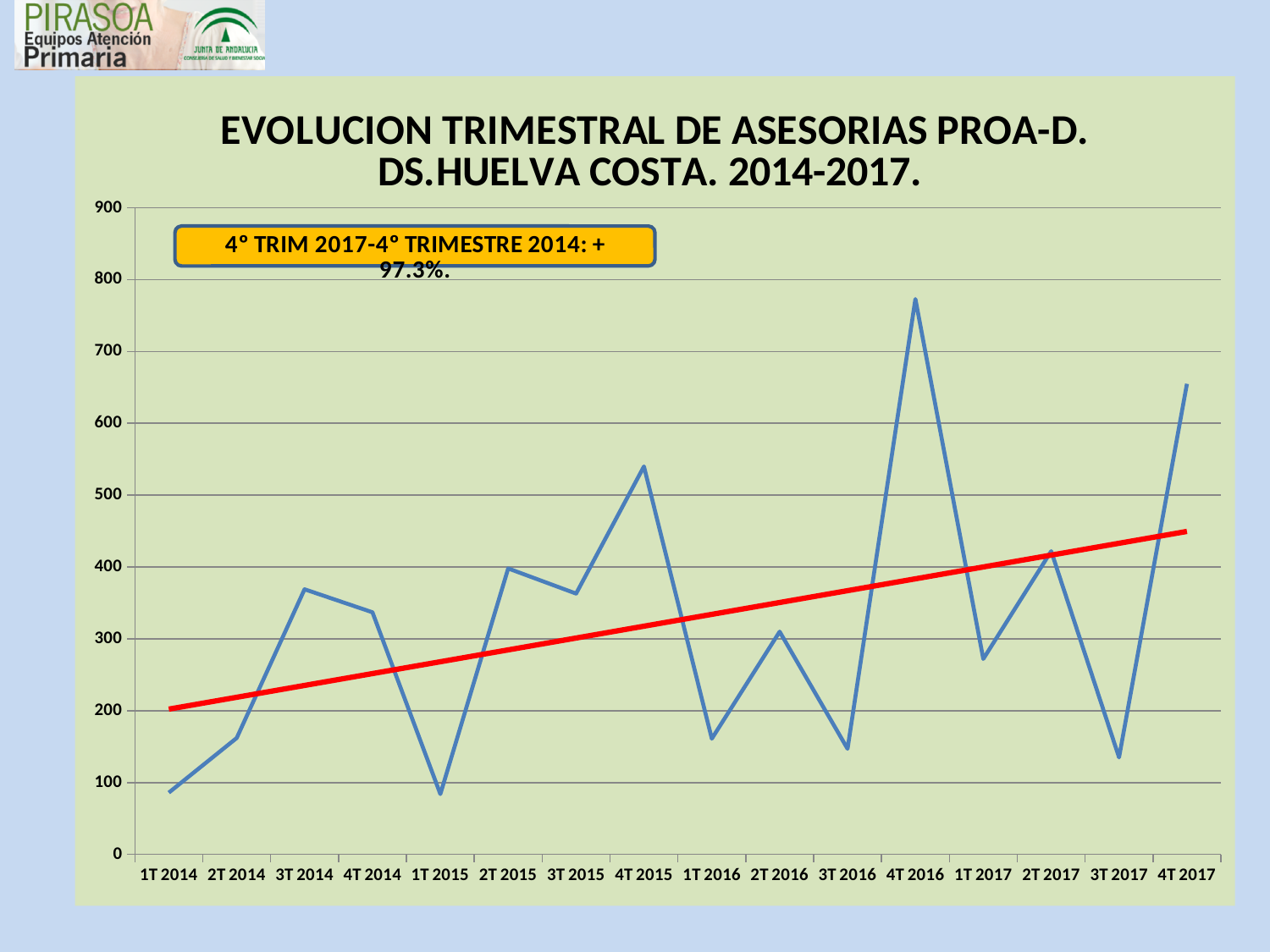
Is the value for 4T 2016 greater or less than 700? greater What kind of chart is shown on the slide? line chart Is the value for 4T 2017 greater or less than 600? greater Which is larger, the value for 4T 2016 or the value for 4T 2017? 4T 2016 According to the red trend line, do the values overall rise or fall from 1T 2014 to 4T 2017? rise Is the value for 3T 2017 greater or less than 200? less How many quarters are plotted along the x axis? 16 Which is larger, the value for 4T 2017 or the value for 4T 2015? 4T 2017 Which quarter has the highest value? 4T 2016 What percentage change between 4T 2014 and 4T 2017 is stated in the highlighted box on the chart? + 97.3%